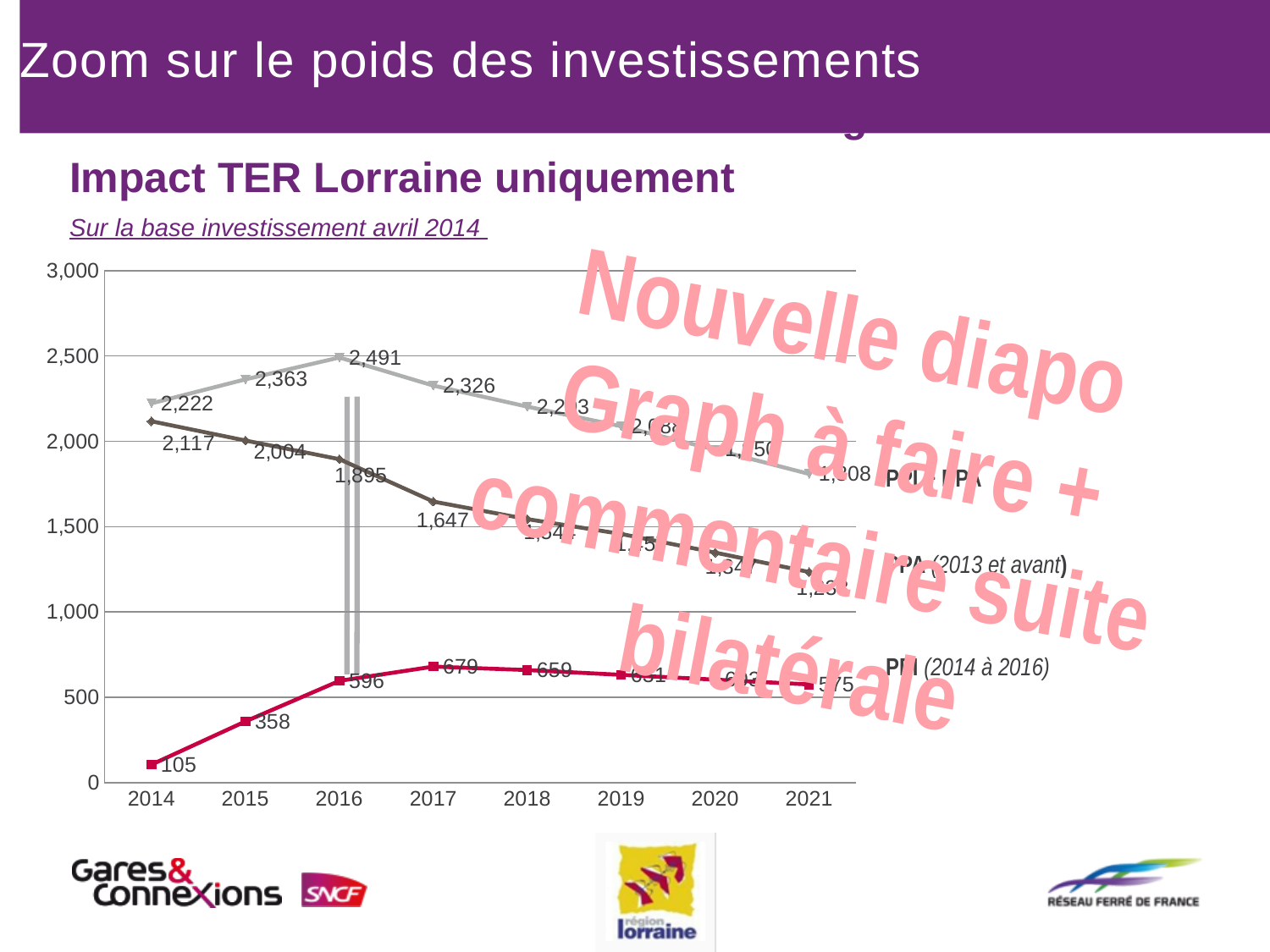
What is the value of the red (bottom) line in 2014? 105 How many years are shown on the x axis? 8 What is the value of the brown (middle) line in 2017? 1,647 What is the value of the grey (top) line in 2016? 2,491 In 2014, which is larger: the grey (top) line or the brown (middle) line? The grey (top) line In which year does the grey (top) line reach its highest value? 2016 In which year does the red (bottom) line reach its highest value? 2017 What kind of chart is shown on the slide? Line chart What is the value of the brown (middle) line in 2015? 2,004 Is the value of the red (bottom) line in 2016 greater or less than 500? greater What is the difference between the red line's 2015 value and its 2014 value? 253 By how much does the grey (top) line increase from 2015 to 2016? 128